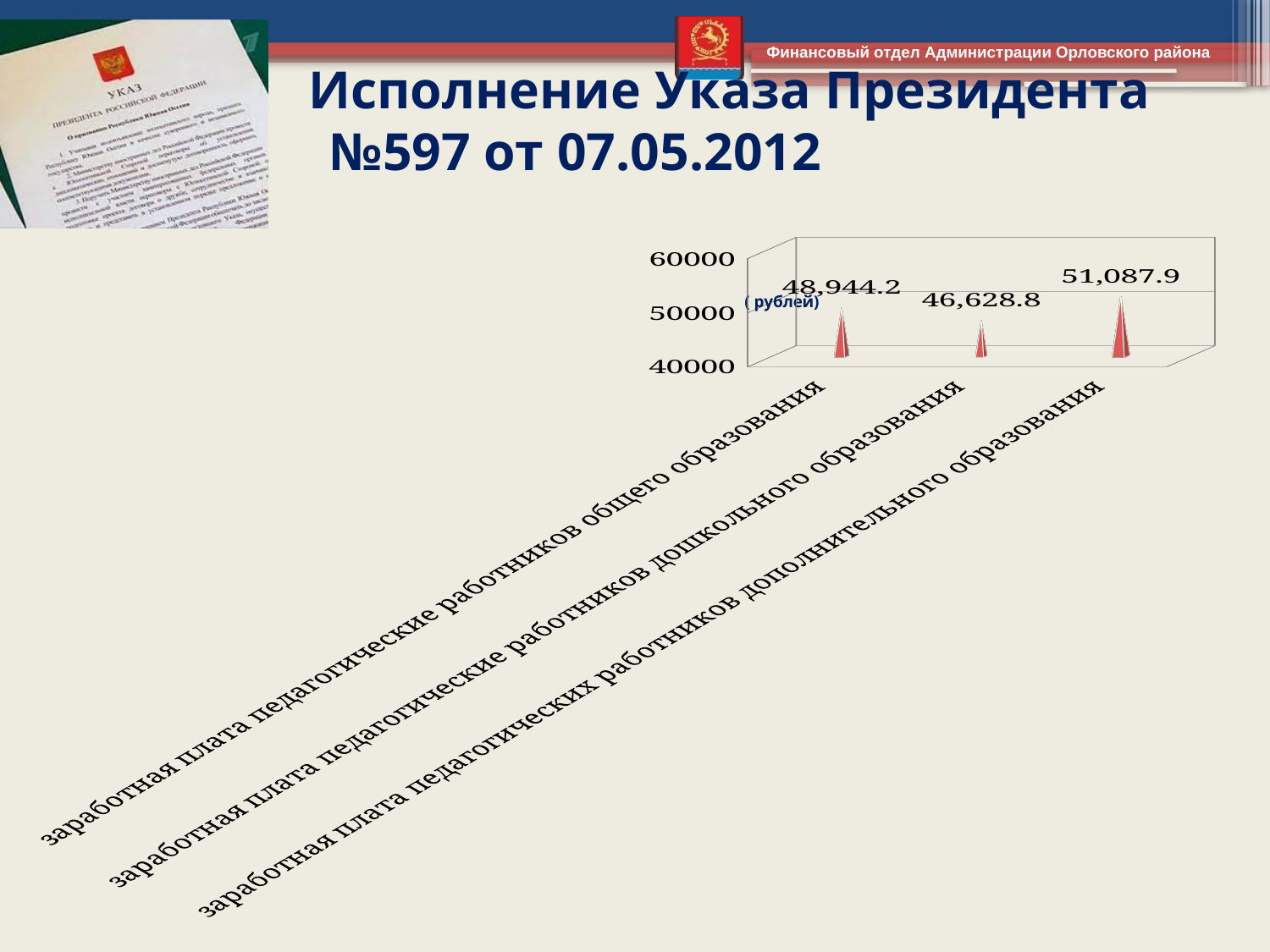
Is the value for дошкольного образования greater or less than 50000? less What is the value for заработная плата педагогических работников дополнительного образования? 51,087.9 Which is larger: the value for общего образования or the value for дошкольного образования? общего образования Is the value for дополнительного образования greater or less than 50000? greater What is the value for заработная плата педагогические работников общего образования? 48,944.2 Which category has the highest value? заработная плата педагогических работников дополнительного образования Which category has the lowest value? заработная плата педагогические работников дошкольного образования What is the difference between the value for дополнительного образования and the value for общего образования? 2,143.7 How many categories are shown in the chart? 3 What unit is indicated on the chart for the values? рублей What is the difference between the value for общего образования and the value for дошкольного образования? 2,315.4 What is the value for заработная плата педагогические работников дошкольного образования? 46,628.8